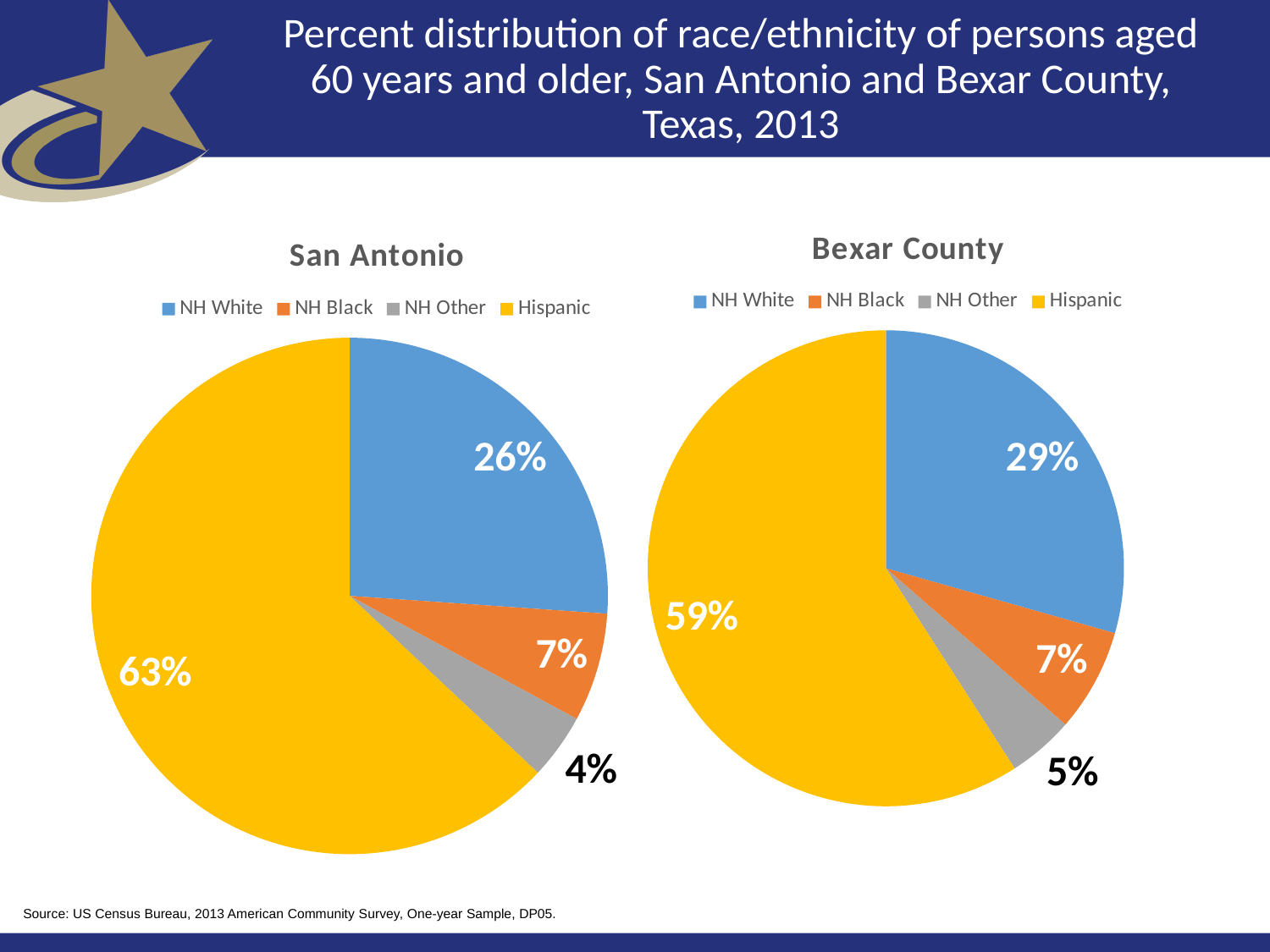
In the Bexar County pie chart, which colour represents Hispanic? Yellow In the San Antonio pie chart, what percentage is shown for Hispanic? 63% In the Bexar County pie chart, which category has the smallest slice? NH Other In the Bexar County pie chart, what percentage is shown for NH White? 29% What is the difference between the Hispanic share in San Antonio and the Hispanic share in Bexar County? 4% What type of chart is used for Bexar County? Pie chart In the Bexar County pie chart, what percentage is shown for NH Black? 7% How many categories does the San Antonio pie chart show? 4 In the San Antonio pie chart, which category has the largest slice? Hispanic In the San Antonio pie chart, what percentage is shown for NH Other? 4% In the San Antonio pie chart, what is the combined share of NH Black and NH Other? 11% Which is larger: the NH White share in San Antonio or the NH White share in Bexar County? Bexar County